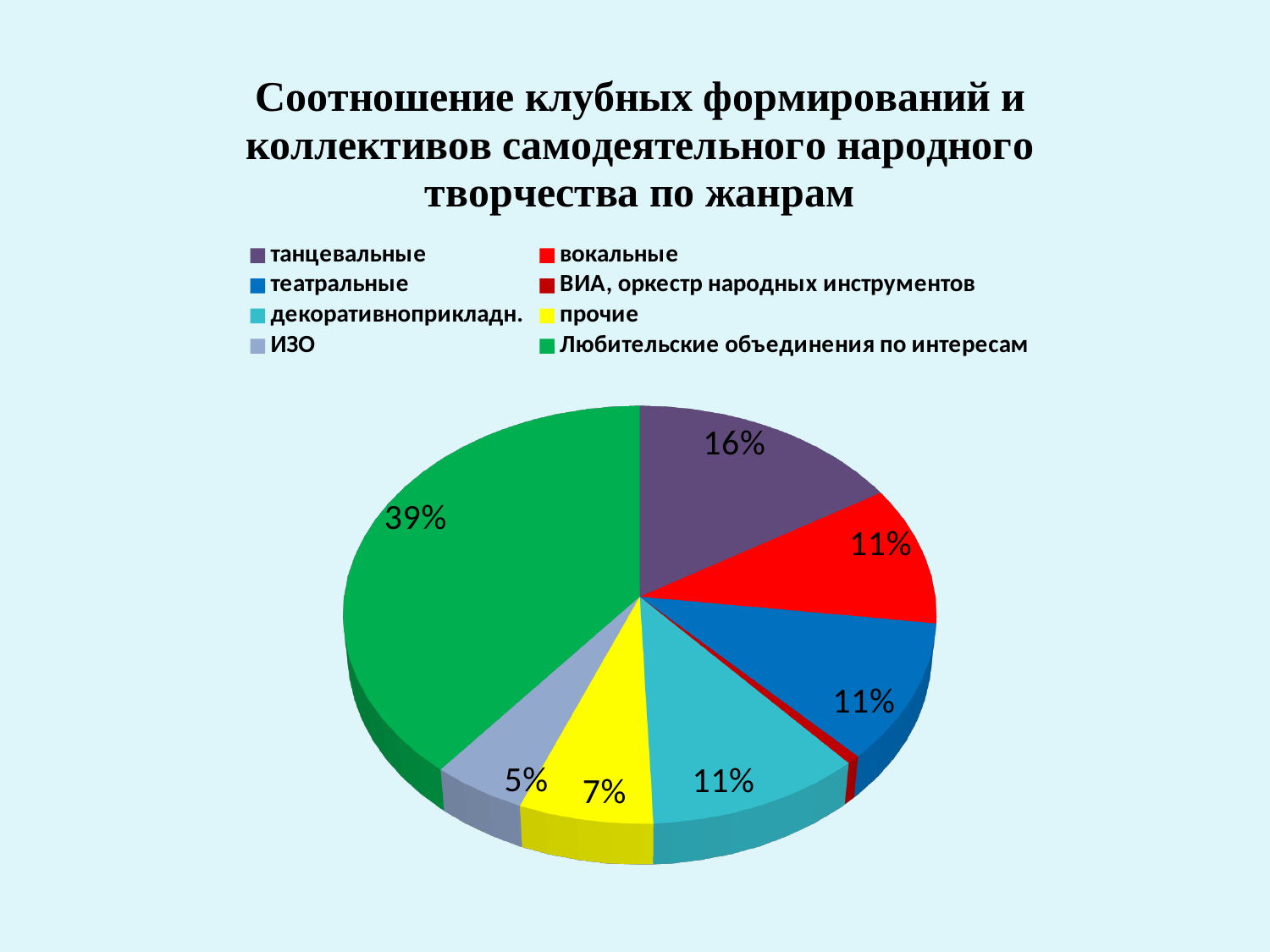
What percentage is shown for the вокальные slice? 11% Which category has the smallest slice of the pie? ВИА, оркестр народных инструментов What is the difference in percentage points between the Любительские объединения по интересам slice and the танцевальные slice? 23% Which slice is larger, танцевальные or прочие? танцевальные What colour is the slice for Любительские объединения по интересам? green How many entries does the legend list? 8 What percentage is shown for the танцевальные slice? 16% What percentage is shown for the прочие slice? 7% Which category has the largest slice of the pie? Любительские объединения по интересам What percentage is shown for the ИЗО slice? 5% What share of the pie is labelled for Любительские объединения по интересам? 39% What kind of chart is shown on the slide? pie chart